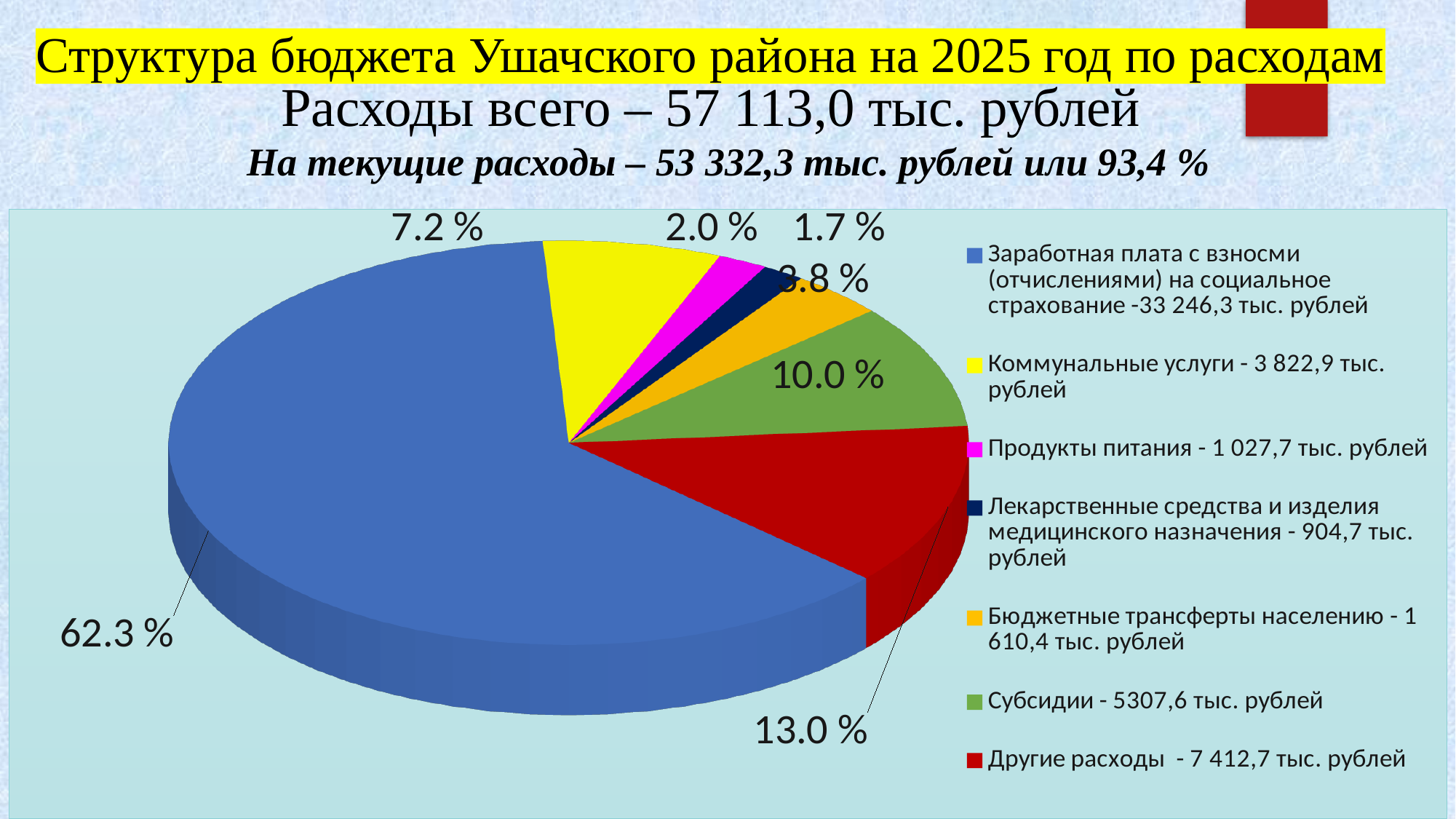
How many entries does the legend of the pie chart list? 7 What percentage share does the slice for 'Субсидии' have? 10.0 % Which slice is larger: 'Субсидии' or 'Коммунальные услуги'? Субсидии What percentage share does the slice for 'Заработная плата с взносми (отчислениями) на социальное страхование' have? 62.3 % Which category has the smallest slice in the pie chart? Лекарственные средства и изделия медицинского назначения Which category has the largest slice in the pie chart? Заработная плата с взносми (отчислениями) на социальное страхование What colour is the slice for 'Другие расходы' in the pie chart? Red What percentage share does the slice for 'Продукты питания' have? 2.0 % How many slices does the pie chart have? 7 What type of chart is shown on the slide? Pie chart